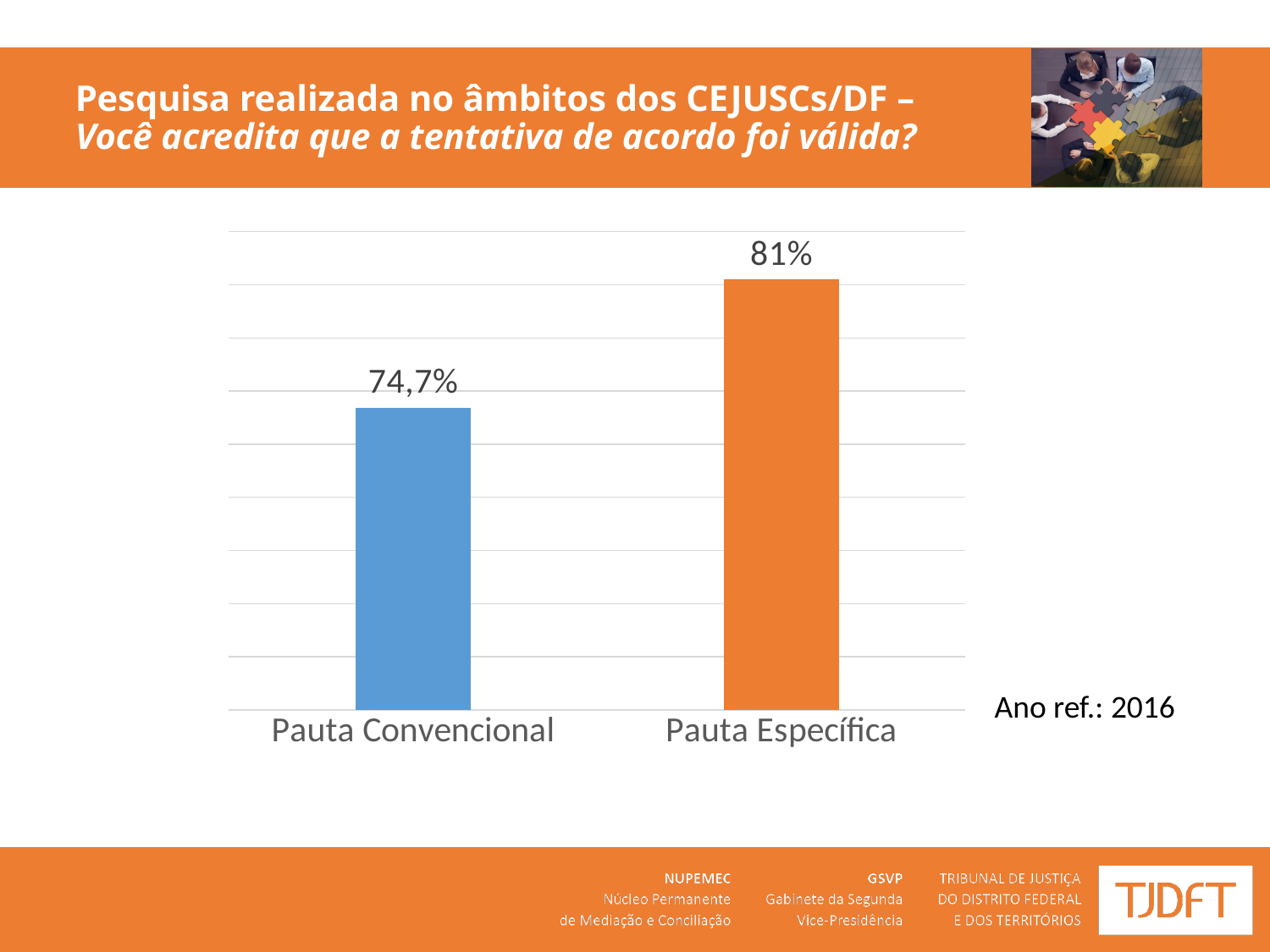
Which is larger, the value for Pauta Convencional or the value for Pauta Específica? Pauta Específica What is the difference between the values for Pauta Específica and Pauta Convencional? 6,3% What is the value for Pauta Convencional? 74,7% How many categories are shown in the chart? 2 What kind of chart is shown on the slide? Bar chart Which category has the lowest value? Pauta Convencional Which category has the highest value? Pauta Específica What reference year is noted next to the chart? 2016 What colour is the bar for Pauta Específica? Orange What is the value for Pauta Específica? 81%